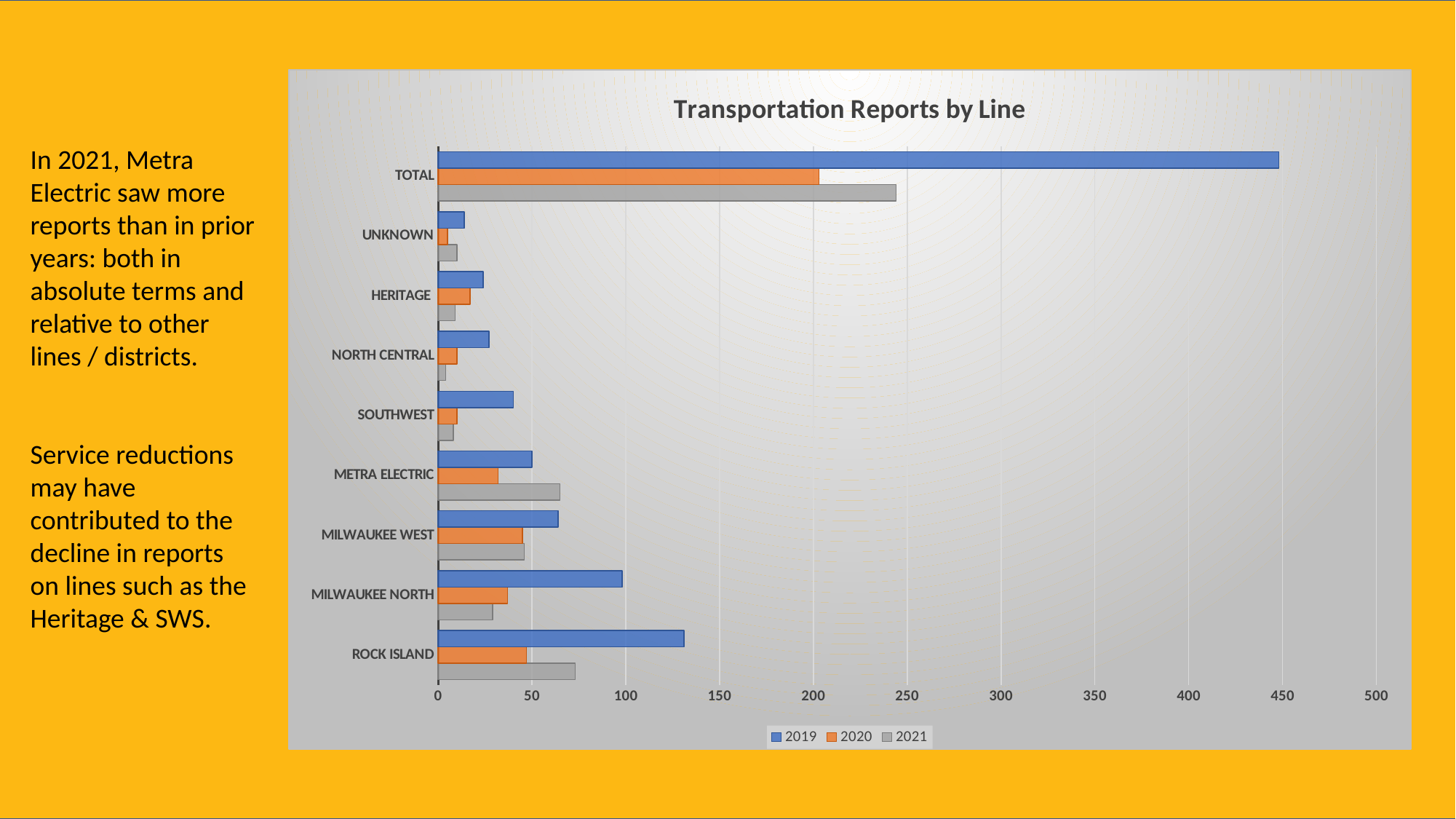
What kind of chart is shown on the slide? bar chart For METRA ELECTRIC, which is larger: the 2020 value or the 2021 value? 2021 Is the 2021 value for TOTAL greater or less than 250? less How many series does the legend list? 3 What is the title of the chart? Transportation Reports by Line Is the 2019 value for ROCK ISLAND greater or less than 100? greater Which is larger: the 2019 value for ROCK ISLAND or the 2019 value for MILWAUKEE NORTH? ROCK ISLAND How many categories are shown on the vertical axis of the chart? 9 Which series is shown in orange in the legend? 2020 Is the 2019 value for TOTAL greater or less than 400? greater Which line (excluding TOTAL) has the highest 2019 value? ROCK ISLAND